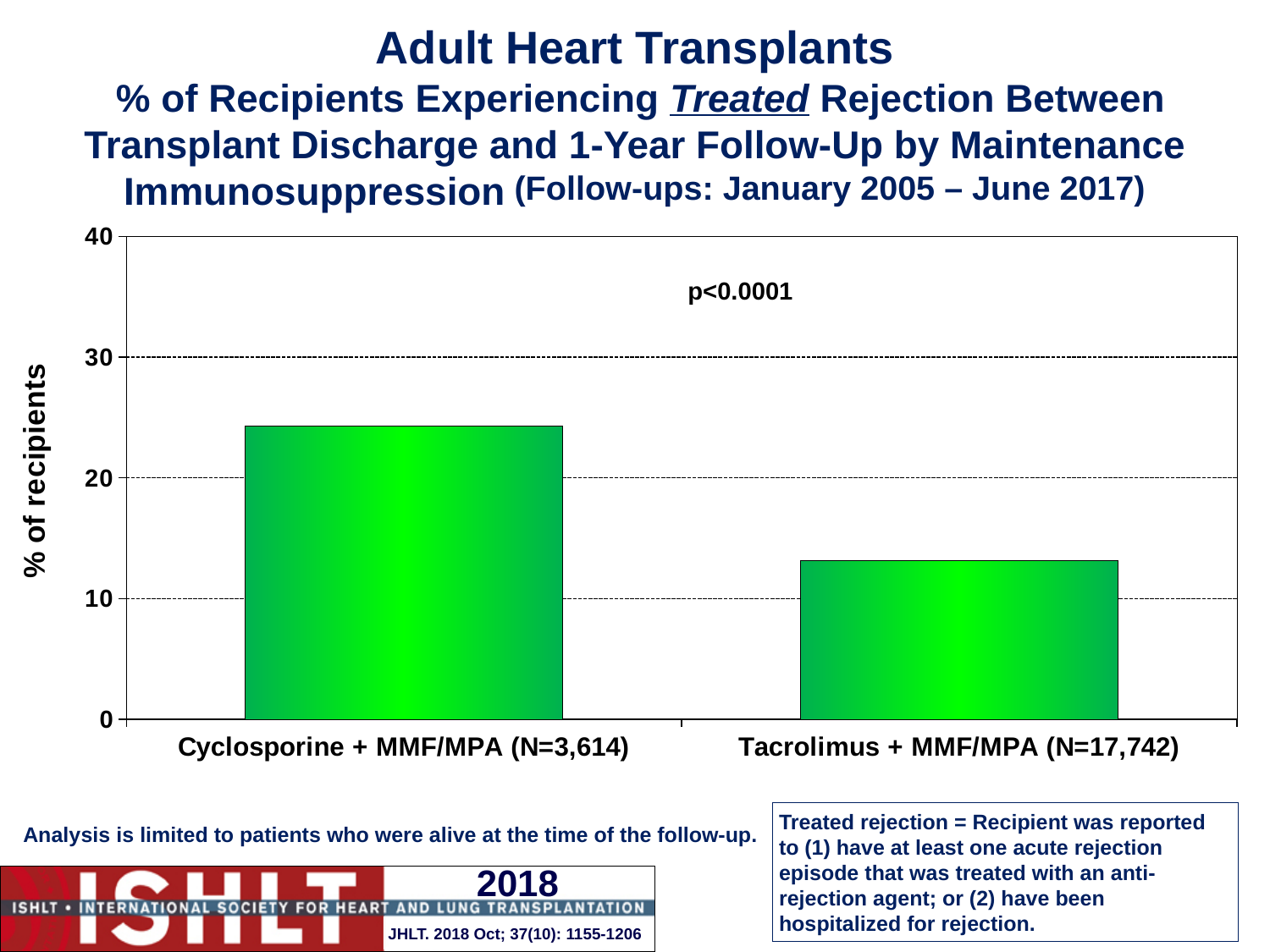
Is the value for Cyclosporine + MMF/MPA (N=3,614) greater or less than 20? greater What is the maximum value shown on the y axis? 40 Which category has the highest % of recipients experiencing treated rejection? Cyclosporine + MMF/MPA (N=3,614) What kind of chart is shown on the slide? bar chart Is the value for Tacrolimus + MMF/MPA (N=17,742) greater or less than 10? greater Is the value for Cyclosporine + MMF/MPA (N=3,614) greater or less than 30? less How many categories (bars) are plotted in the chart? 2 Which is larger: the value for Cyclosporine + MMF/MPA or the value for Tacrolimus + MMF/MPA? Cyclosporine + MMF/MPA What is the label of the y axis? % of recipients What p-value is printed on the chart? p<0.0001 Which category has the lowest % of recipients experiencing treated rejection? Tacrolimus + MMF/MPA (N=17,742)